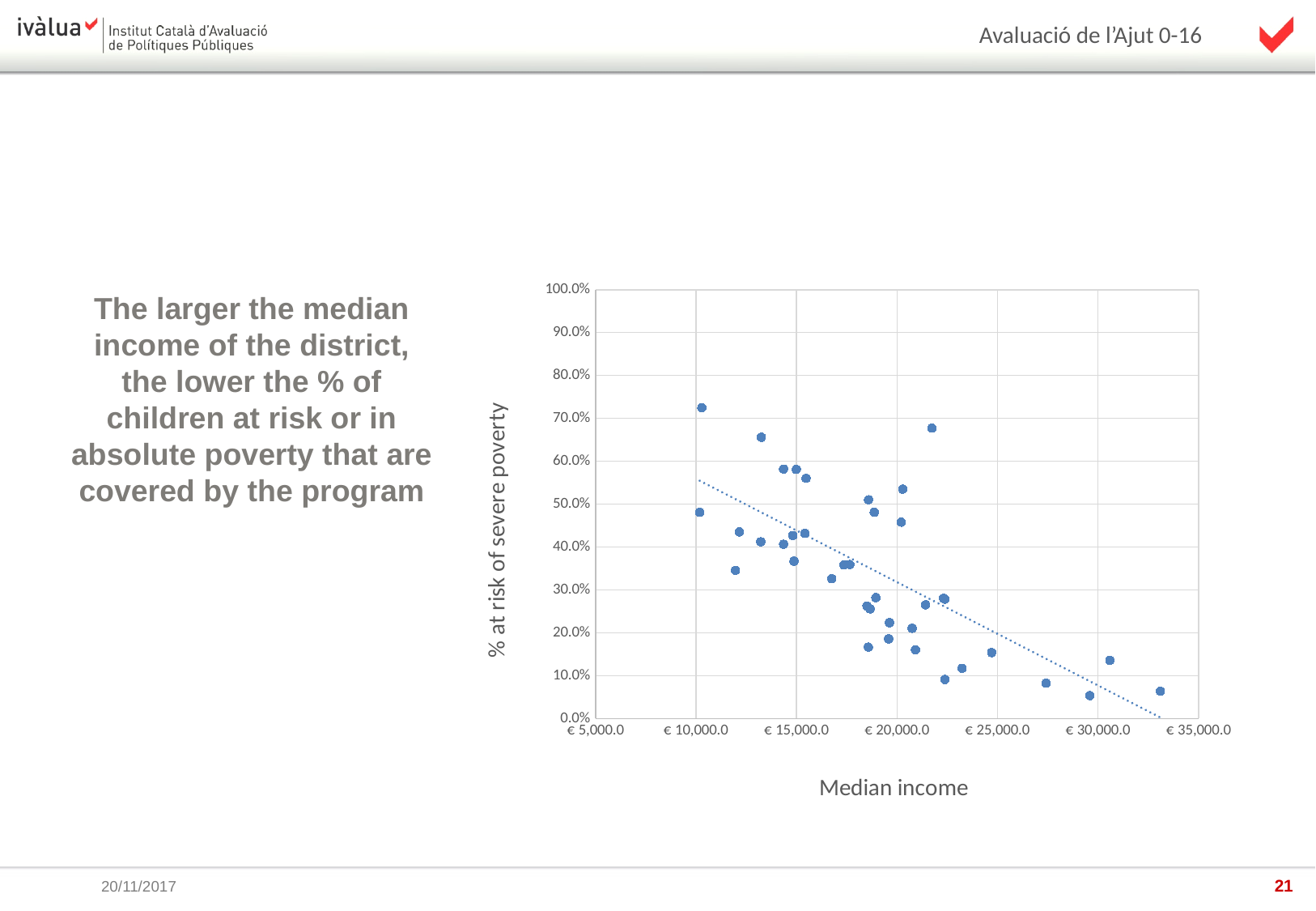
What is the highest value shown on the x axis of the chart? € 35,000.0 As median income increases along the x axis, does the % at risk of severe poverty generally rise or fall? fall Is the highest plotted point on the chart greater or less than 70%? greater What is the label of the x axis of the chart? Median income Is the lowest plotted point on the chart greater or less than 10%? less Is the value for the point with the highest median income greater or less than 10%? less What kind of chart is shown on the slide? scatter chart What is the highest value shown on the y axis of the chart? 100.0%